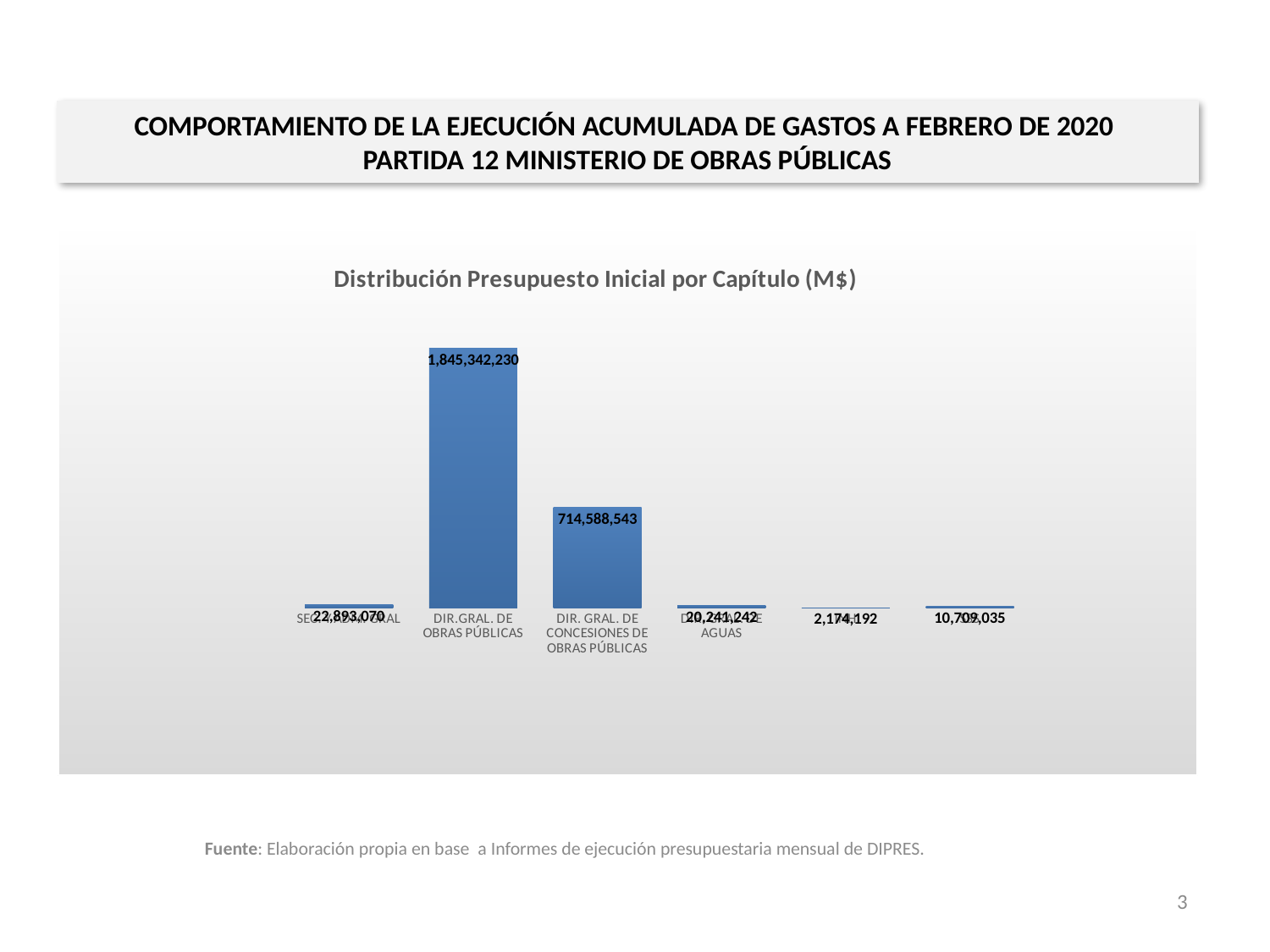
What unit is indicated in the chart title? M$ Which is larger, the value for DIR.GRAL. DE OBRAS PÚBLICAS or the value for DIR. GRAL. DE CONCESIONES DE OBRAS PÚBLICAS? DIR.GRAL. DE OBRAS PÚBLICAS How many bars (categories) does the chart show? 6 What is the difference between the values for DIR.GRAL. DE OBRAS PÚBLICAS and DIR. GRAL. DE CONCESIONES DE OBRAS PÚBLICAS? 1,130,753,687 What is the smallest value labelled on the chart? 2,174,192 What is the value for DIR.GRAL. DE OBRAS PÚBLICAS? 1,845,342,230 What kind of chart is shown on the slide? bar chart Which category has the highest value? DIR.GRAL. DE OBRAS PÚBLICAS What is the value for DIR. GRAL. DE CONCESIONES DE OBRAS PÚBLICAS? 714,588,543 What is the title of the chart? Distribución Presupuesto Inicial por Capítulo (M$) What is the largest value labelled on the chart? 1,845,342,230